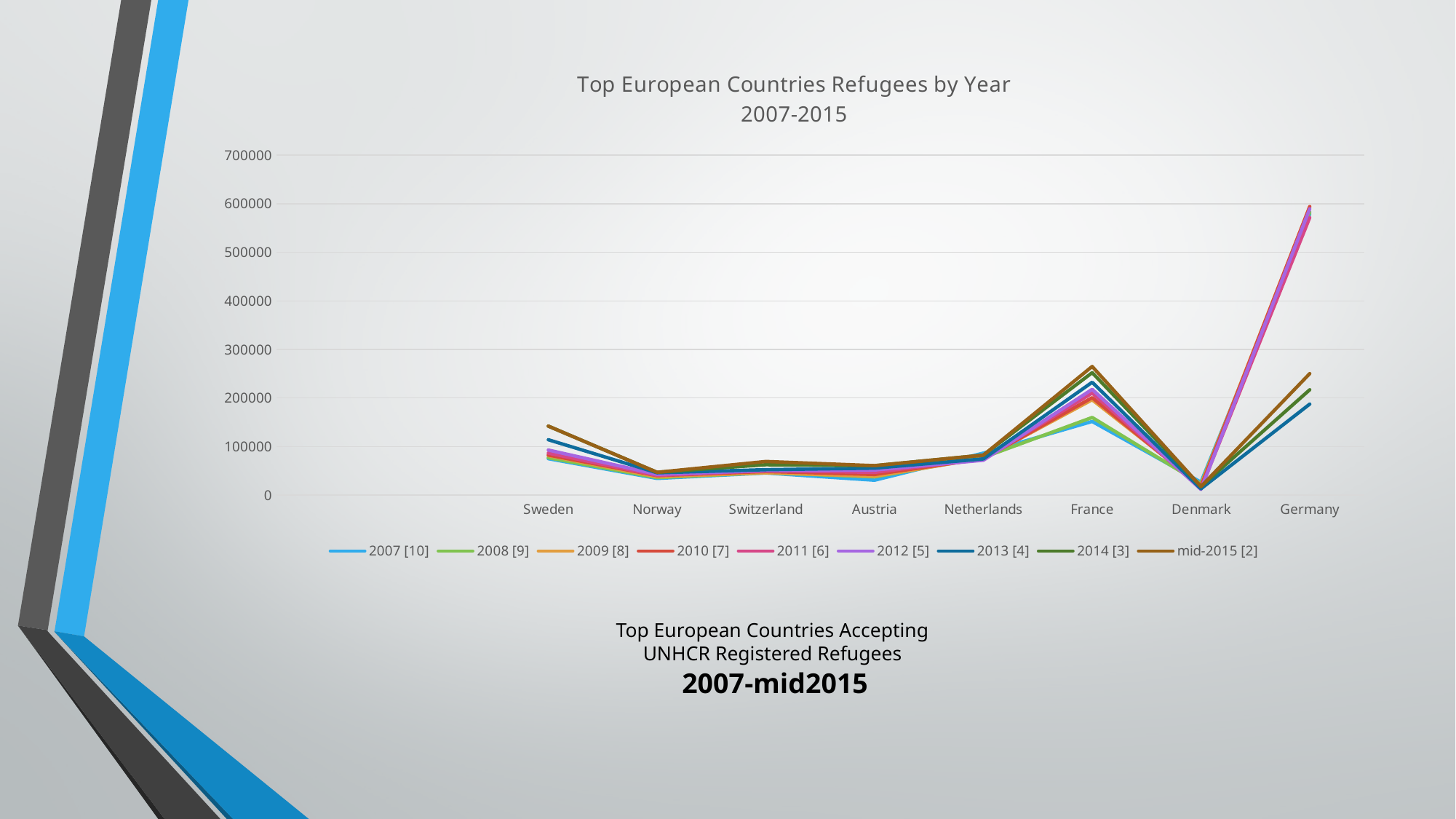
How many series does the chart's legend list? 9 Is the value for Germany in the 2007 [10] series greater or less than 500000? greater Which country has the lowest value for the 2007 [10] series? Denmark Which country has the highest value for the 2007 [10] series? Germany Is the value for Sweden in the mid-2015 [2] series greater or less than 100000? greater What kind of chart is shown on the slide? line chart In the 2007 [10] series, which is larger, the value for Germany or the value for France? Germany How many countries are shown on the x axis of the chart? 8 Is the value for France in the mid-2015 [2] series greater or less than 200000? greater What is the title of the chart? Top European Countries Refugees by Year 2007-2015 Which legend entry is the last one listed in the chart's legend? mid-2015 [2]